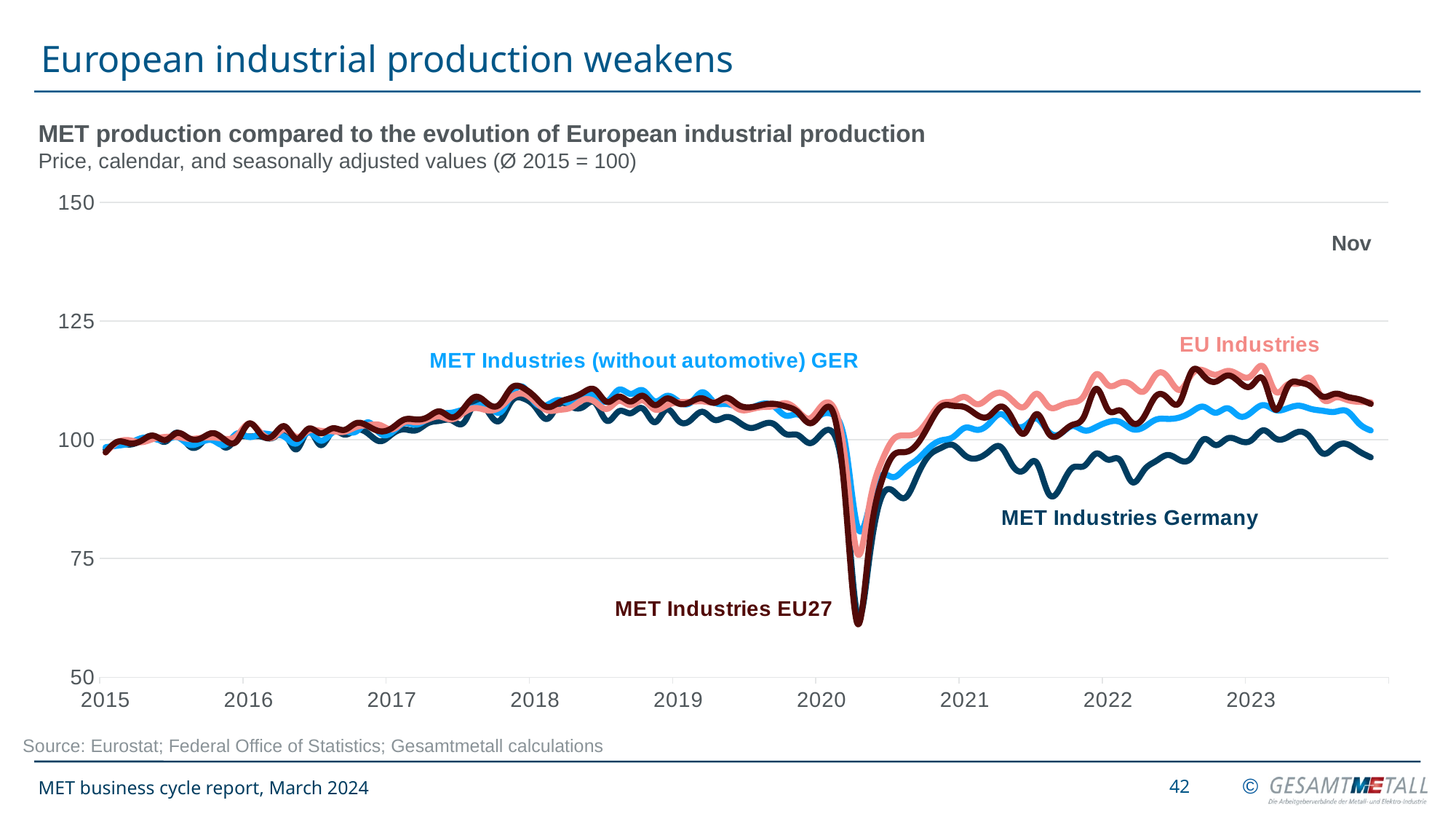
Which series reaches the lowest value on the chart, in 2020? MET Industries EU27 How many series are plotted on the chart? 4 At the end of the chart, which is larger: EU Industries or MET Industries Germany? EU Industries Is the value for EU Industries at the end of the chart greater or less than 100? greater Which series has the lowest value at the end of the chart (Nov 2023)? MET Industries Germany Is the lowest value of MET Industries EU27 in 2020 greater or less than 75? less Which month is labelled as the last data point on the chart? Nov Does the MET Industries EU27 series rise or fall between 2015 and 2019? rise What base year is the index set to 100 according to the subtitle? 2015 Does the EU Industries series rise or fall over the second half of 2023? fall What kind of chart is shown on the slide? line chart Is the value for MET Industries Germany at the end of the chart greater or less than 100? less